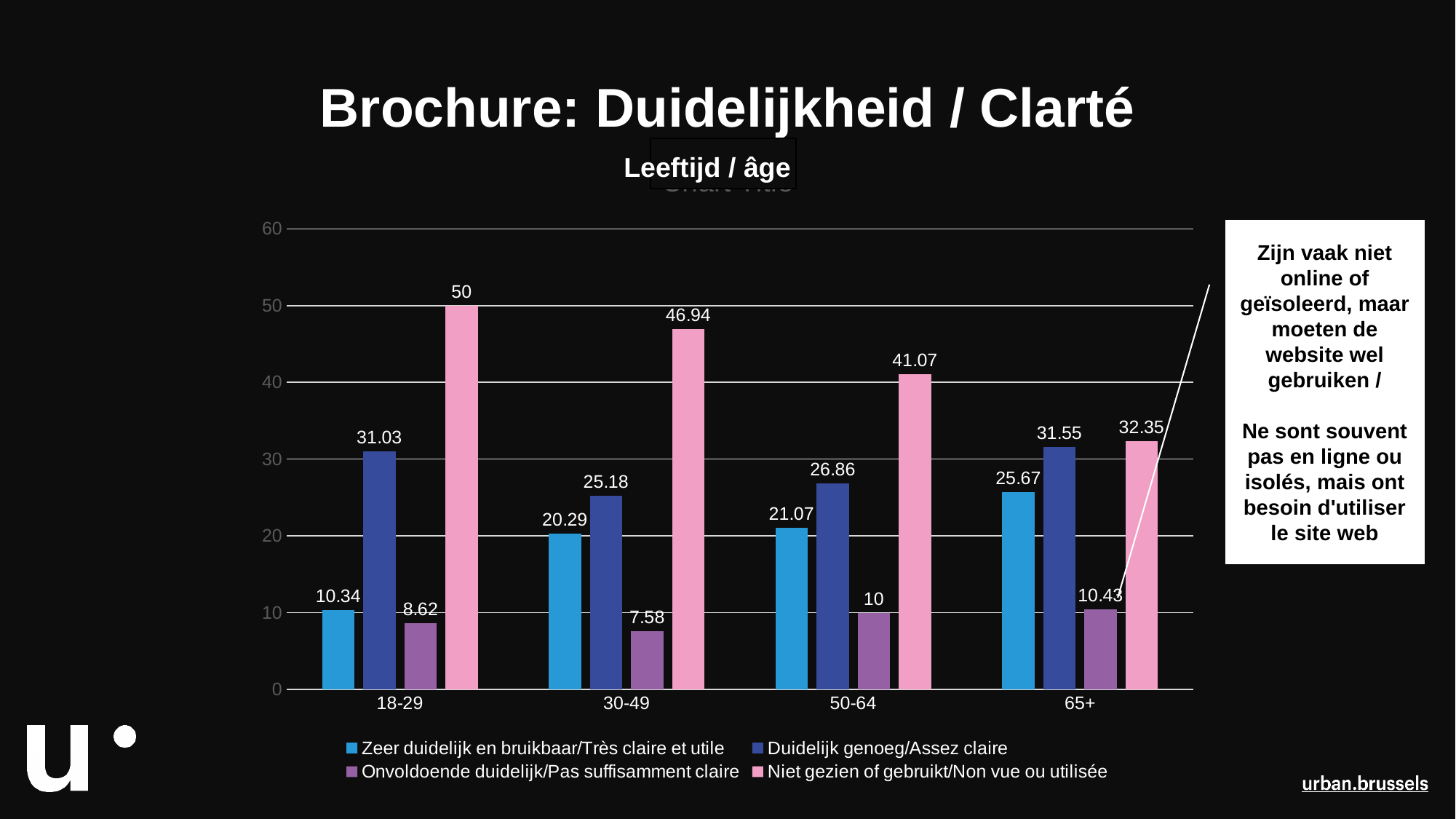
Which is larger in the 50-64 age group: 'Duidelijk genoeg/Assez claire' or 'Zeer duidelijk en bruikbaar/Très claire et utile'? Duidelijk genoeg/Assez claire How many series does the legend list? 4 How many age groups are shown on the x axis? 4 Which age group has the highest value for 'Niet gezien of gebruikt/Non vue ou utilisée'? 18-29 Which age group has the lowest value for 'Zeer duidelijk en bruikbaar/Très claire et utile'? 18-29 Is the value for 'Niet gezien of gebruikt/Non vue ou utilisée' in the 50-64 age group greater or less than 40? greater What is the value for 'Niet gezien of gebruikt/Non vue ou utilisée' in the 18-29 age group? 50 Does the value for 'Niet gezien of gebruikt/Non vue ou utilisée' rise or fall across the age groups from 18-29 to 65+? Fall What is the value for 'Onvoldoende duidelijk/Pas suffisamment claire' in the 30-49 age group? 7.58 What is the value for 'Zeer duidelijk en bruikbaar/Très claire et utile' in the 65+ age group? 25.67 What is the difference between the 'Niet gezien of gebruikt/Non vue ou utilisée' values for the 18-29 and 65+ age groups? 17.65 What kind of chart is shown on the slide? Bar chart